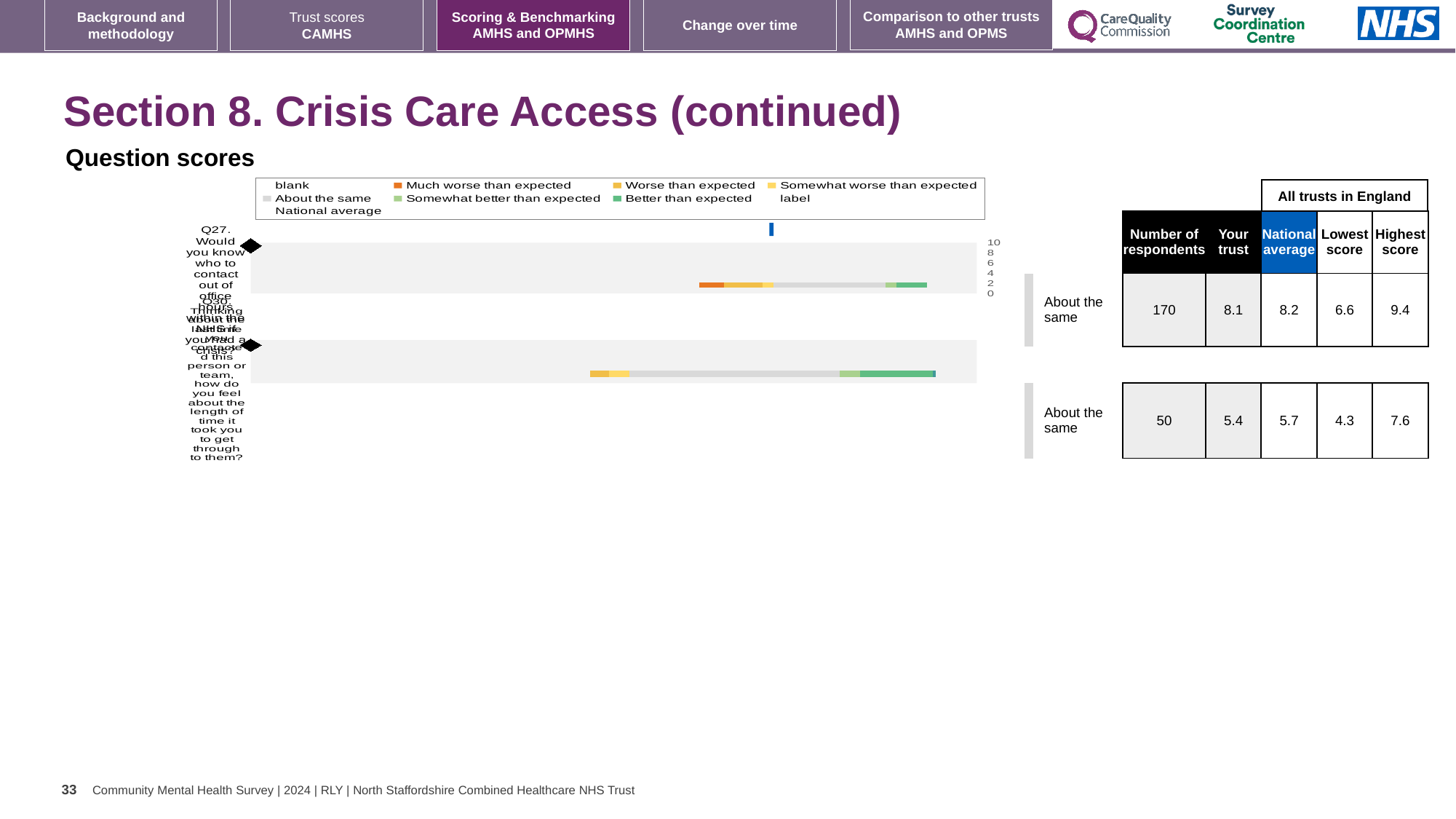
What is the difference between the highest score and the lowest score across all trusts in England for Q27? 2.8 What benchmark category is shown for both Q27 and Q30? About the same For Q30, which is larger: the trust's score or the national average? National average What is the 'Your trust' score for Q30 (how do you feel about the length of time it took you to get through)? 5.4 What is the 'Your trust' score for Q27 (would you know who to contact out of office hours)? 8.1 What kind of chart is used to show the question scores on this slide? bar chart How many questions are plotted in the question scores chart? 2 What is the national average score for Q30? 5.7 How many respondents answered Q30? 50 What is the national average score for Q27? 8.2 How many respondents answered Q27? 170 In the chart legend, what colour represents 'Much worse than expected'? Orange